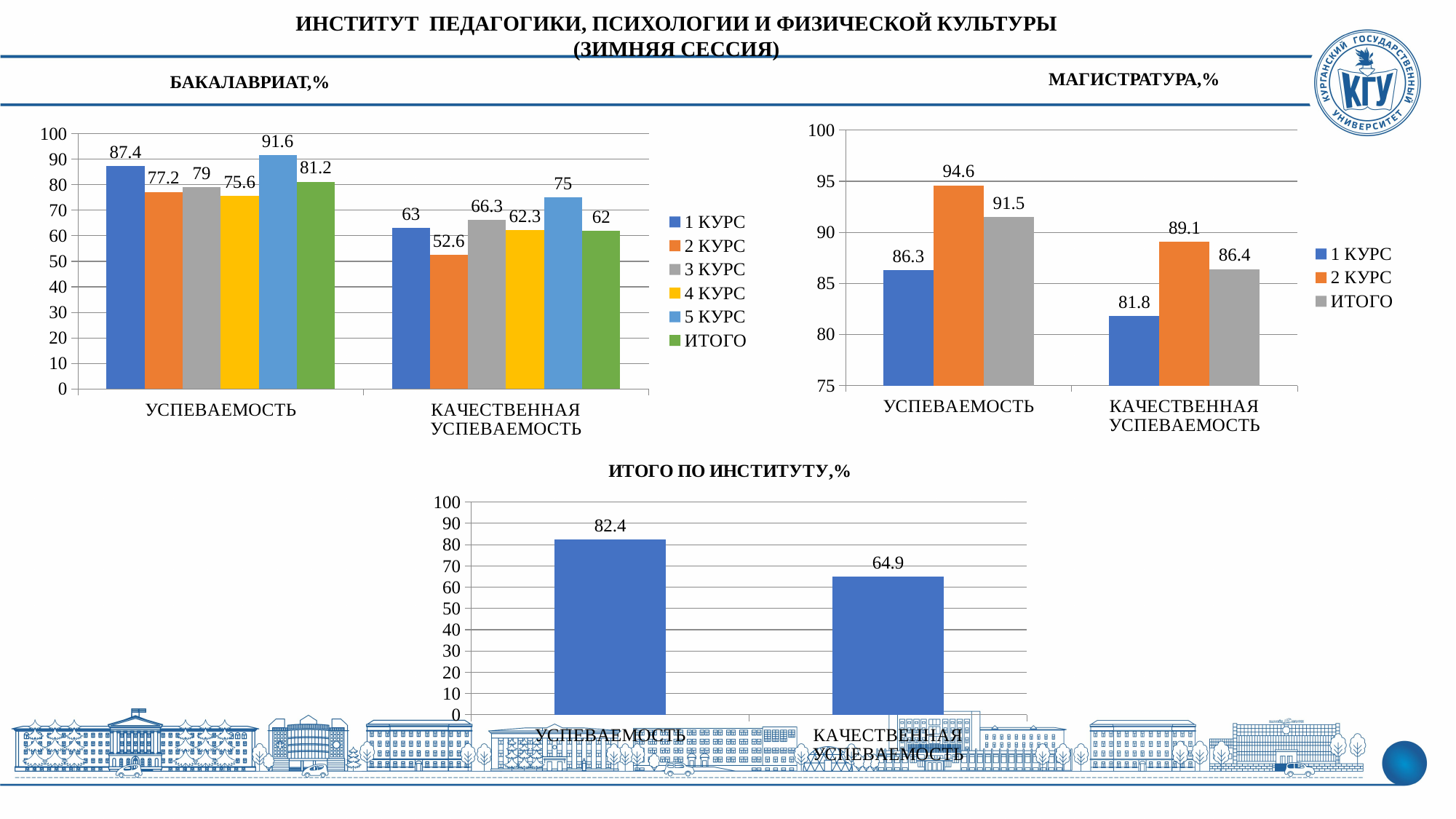
In the МАГИСТРАТУРА,% chart, what is the difference between the 2 КУРС and 1 КУРС values for КАЧЕСТВЕННАЯ УСПЕВАЕМОСТЬ? 7.3 In the БАКАЛАВРИАТ,% chart, which series has the lowest value in the КАЧЕСТВЕННАЯ УСПЕВАЕМОСТЬ category? 2 КУРС In the БАКАЛАВРИАТ,% chart, what is the difference between the ИТОГО values for УСПЕВАЕМОСТЬ and КАЧЕСТВЕННАЯ УСПЕВАЕМОСТЬ? 19.2 In the БАКАЛАВРИАТ,% chart, what is the value for 5 КУРС in the УСПЕВАЕМОСТЬ category? 91.6 In the БАКАЛАВРИАТ,% chart, how many series does the legend list? 6 In the ИТОГО ПО ИНСТИТУТУ,% chart, how many categories are shown on the x axis? 2 In the БАКАЛАВРИАТ,% chart, what is the value for 2 КУРС in the КАЧЕСТВЕННАЯ УСПЕВАЕМОСТЬ category? 52.6 What kind of chart is the ИТОГО ПО ИНСТИТУТУ,% chart? bar chart In the МАГИСТРАТУРА,% chart, is the value for 1 КУРС in УСПЕВАЕМОСТЬ larger or smaller than the value for ИТОГО in УСПЕВАЕМОСТЬ? smaller In the МАГИСТРАТУРА,% chart, which series has the highest value in the КАЧЕСТВЕННАЯ УСПЕВАЕМОСТЬ category? 2 КУРС In the ИТОГО ПО ИНСТИТУТУ,% chart, what is the value for УСПЕВАЕМОСТЬ? 82.4 In the МАГИСТРАТУРА,% chart, what is the value for 2 КУРС in the УСПЕВАЕМОСТЬ category? 94.6